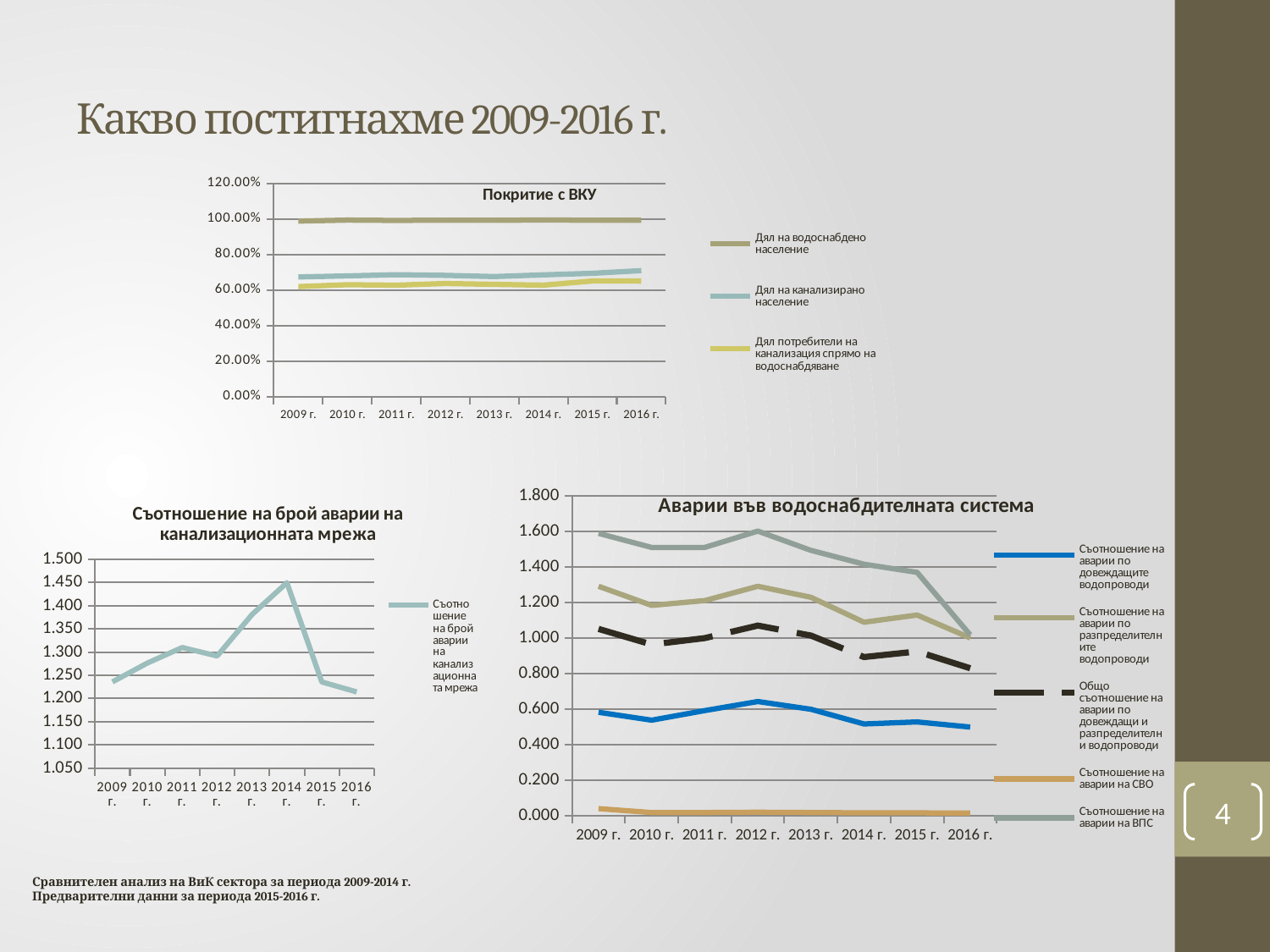
How many series does the legend of the 'Аварии във водоснабдителната система' chart list? 5 In the 'Съотношение на брой аварии на канализационната мрежа' chart, is the value for 2014 г. greater or less than 1.400? greater In the 'Съотношение на брой аварии на канализационната мрежа' chart, is the value for 2016 г. greater or less than 1.250? less In the 'Покритие с ВКУ' chart, which series has the highest values across all years? Дял на водоснабдено население How many years are shown on the x axis of the 'Съотношение на брой аварии на канализационната мрежа' chart? 8 What type of chart is the 'Покритие с ВКУ' chart? line chart In the 'Покритие с ВКУ' chart, is the value for 'Дял на водоснабдено население' in 2016 г. greater or less than 80.00%? greater In the 'Аварии във водоснабдителната система' chart, do the values for 'Съотношение на аварии на ВПС' rise or fall from 2009 г. to 2016 г.? fall In the 'Аварии във водоснабдителната система' chart, which series has the lowest values across all years? Съотношение на аварии на СВО How many series does the legend of the 'Покритие с ВКУ' chart list? 3 In the 'Съотношение на брой аварии на канализационната мрежа' chart, which year has the highest value? 2014 г.